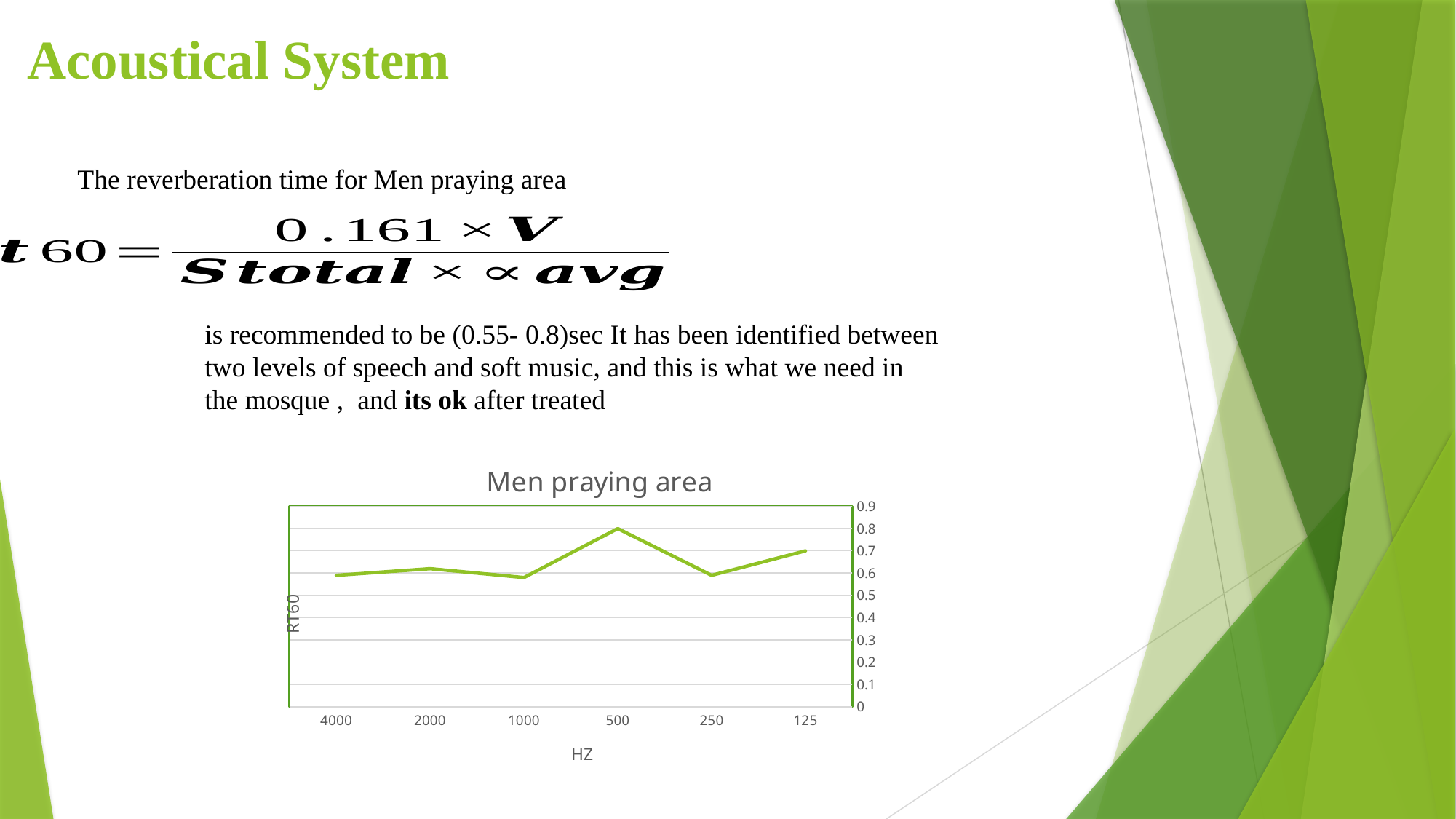
Which has the larger RT60 value, 500 HZ or 250 HZ? 500 At which frequency (HZ) is the RT60 value highest? 500 Is the RT60 value at 500 HZ greater or less than 0.7? greater What kind of chart is shown on the slide? line chart Which has the larger RT60 value, 125 HZ or 1000 HZ? 125 Is the RT60 value at 1000 HZ greater or less than 0.5? greater What is the label of the vertical axis of the chart? RT60 Does the RT60 value rise or fall between 500 HZ and 250 HZ? fall What is the title of the chart? Men praying area How many frequency categories are plotted on the x axis of the chart? 6 Is the RT60 value at 250 HZ greater or less than 0.7? less